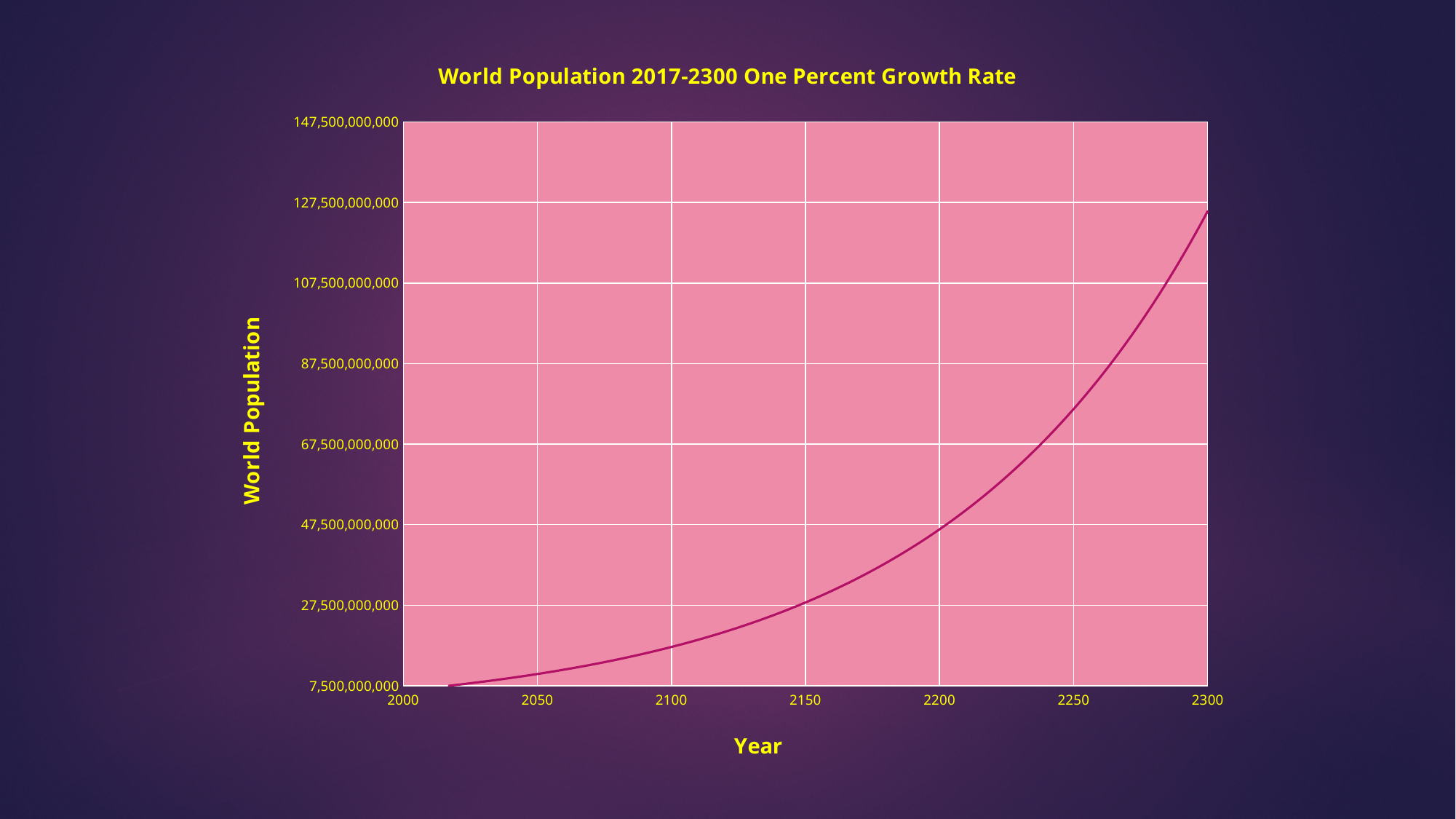
Which is larger, the world population in 2300 or in 2100? 2300 What is the title of the chart? World Population 2017-2300 One Percent Growth Rate Is the value for the year 2250 greater or less than 67,500,000,000? greater Is the value for the year 2250 greater or less than 87,500,000,000? less Is the value for the year 2100 greater or less than 27,500,000,000? less Does the world population rise or fall as the year increases along the x axis? rises What is the label of the vertical axis? World Population What kind of chart is shown on the slide? line chart Which year shown on the x axis has the highest world population? 2300 What is the highest value shown on the vertical axis? 147,500,000,000